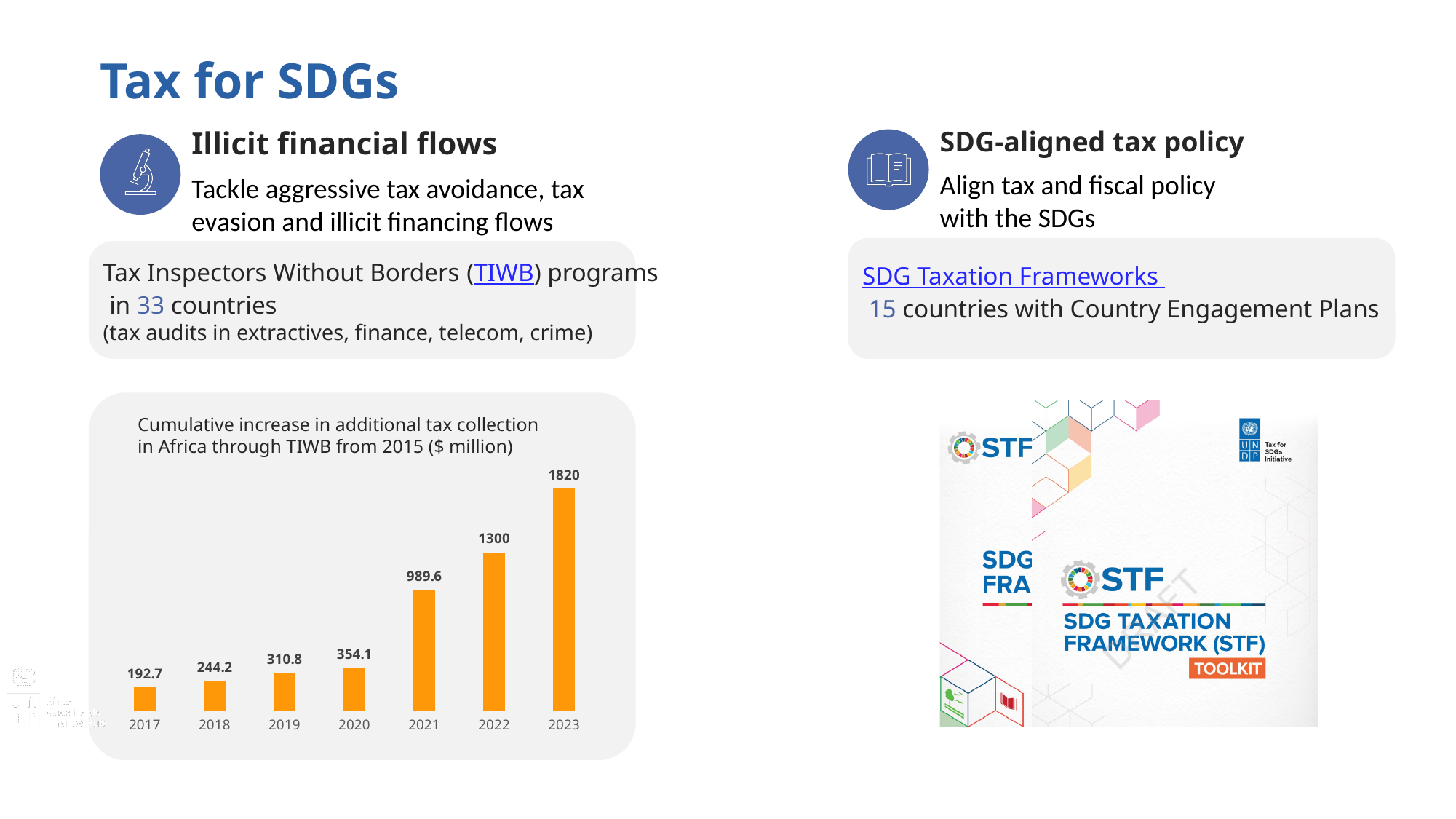
What is the value for 2022 in the chart? 1300 What is the value for 2017 in the chart? 192.7 What is the difference between the values for 2023 and 2022? 520 How many years are shown in the chart? 7 What is the difference between the values for 2019 and 2018? 66.6 What is the value for 2020 in the chart? 354.1 What kind of chart is shown on the slide? Bar chart What is the title of the chart? Cumulative increase in additional tax collection in Africa through TIWB from 2015 ($ million) Do the values rise or fall from 2017 to 2023? Rise Which year has the lowest value in the chart? 2017 Which is larger, the value for 2021 or the value for 2020? 2021 Which year has the highest value in the chart? 2023